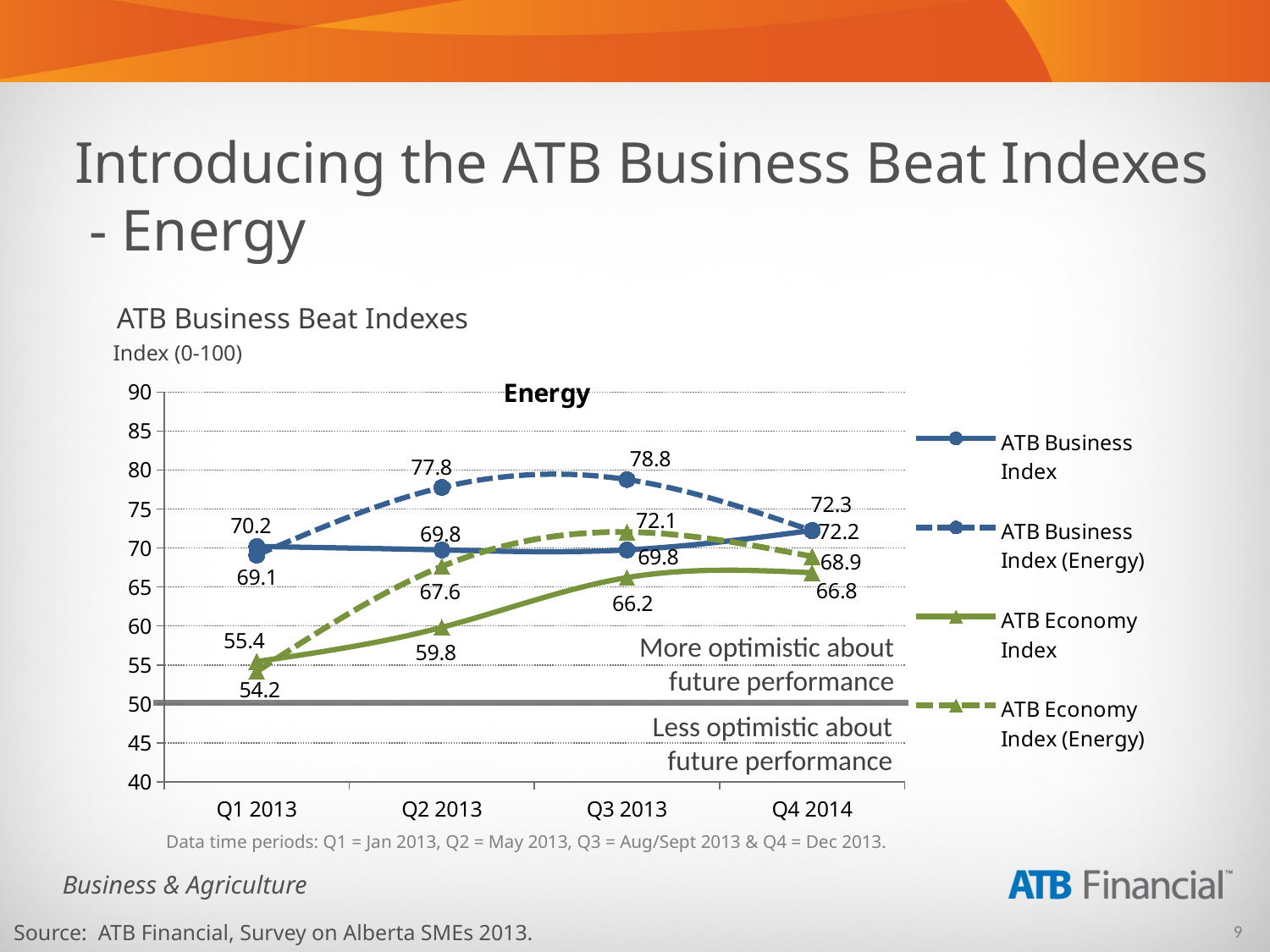
What is the value of the ATB Economy Index (Energy) in Q2 2013? 67.6 By how much did the ATB Business Index (Energy) change from Q2 2013 to Q3 2013? 1.0 What is the value of the ATB Business Index (Energy) in Q3 2013? 78.8 In which period is the ATB Economy Index (Energy) at its lowest? Q1 2013 How many time periods are shown on the x axis? 4 In Q2 2013, which is higher: the ATB Business Index (Energy) or the ATB Economy Index (Energy)? ATB Business Index (Energy) What is the title printed inside the chart area? Energy Does the ATB Economy Index rise or fall from Q1 2013 to Q4 2014? Rises What kind of chart is shown on the slide? Line chart In which period does the ATB Business Index (Energy) reach its highest value? Q3 2013 How many series does the legend list? 4 What is the value of the ATB Economy Index in Q1 2013? 55.4